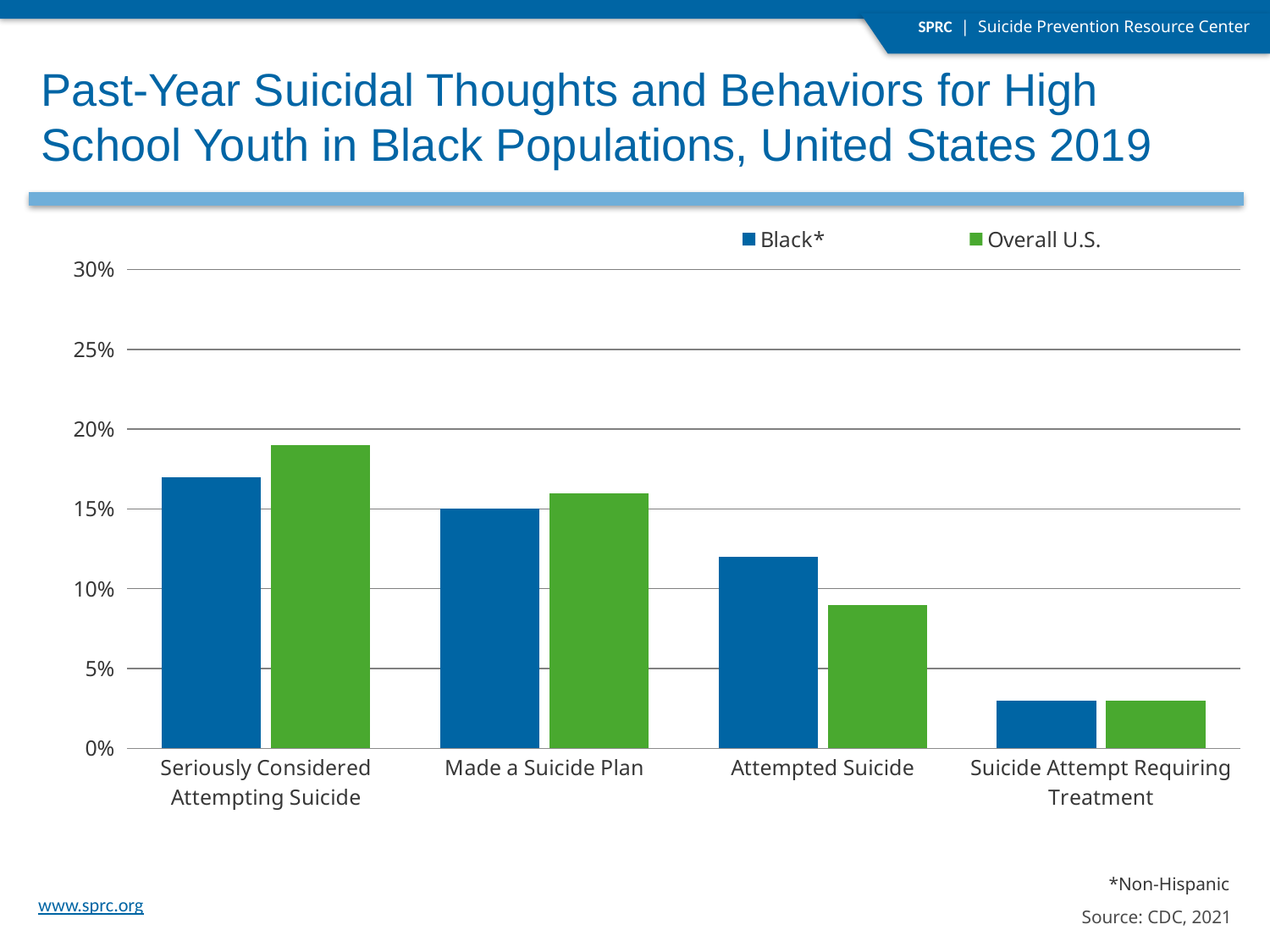
How many categories are shown on the x axis? 4 Is the Black* value for Suicide Attempt Requiring Treatment greater or less than 5%? less Which category has the highest value for the Black* series? Seriously Considered Attempting Suicide How many series does the legend list? 2 Do the values for the Black* series rise or fall moving from left to right across the categories? fall What colour are the bars for the Overall U.S. series? green What kind of chart is shown on the slide? bar chart Is the Black* value for Seriously Considered Attempting Suicide greater or less than 15%? greater Which category has the lowest value for the Overall U.S. series? Suicide Attempt Requiring Treatment Is the Overall U.S. value for Attempted Suicide greater or less than 10%? less For Attempted Suicide, which series has the larger value, Black* or Overall U.S.? Black* For Seriously Considered Attempting Suicide, which series has the larger value, Black* or Overall U.S.? Overall U.S.